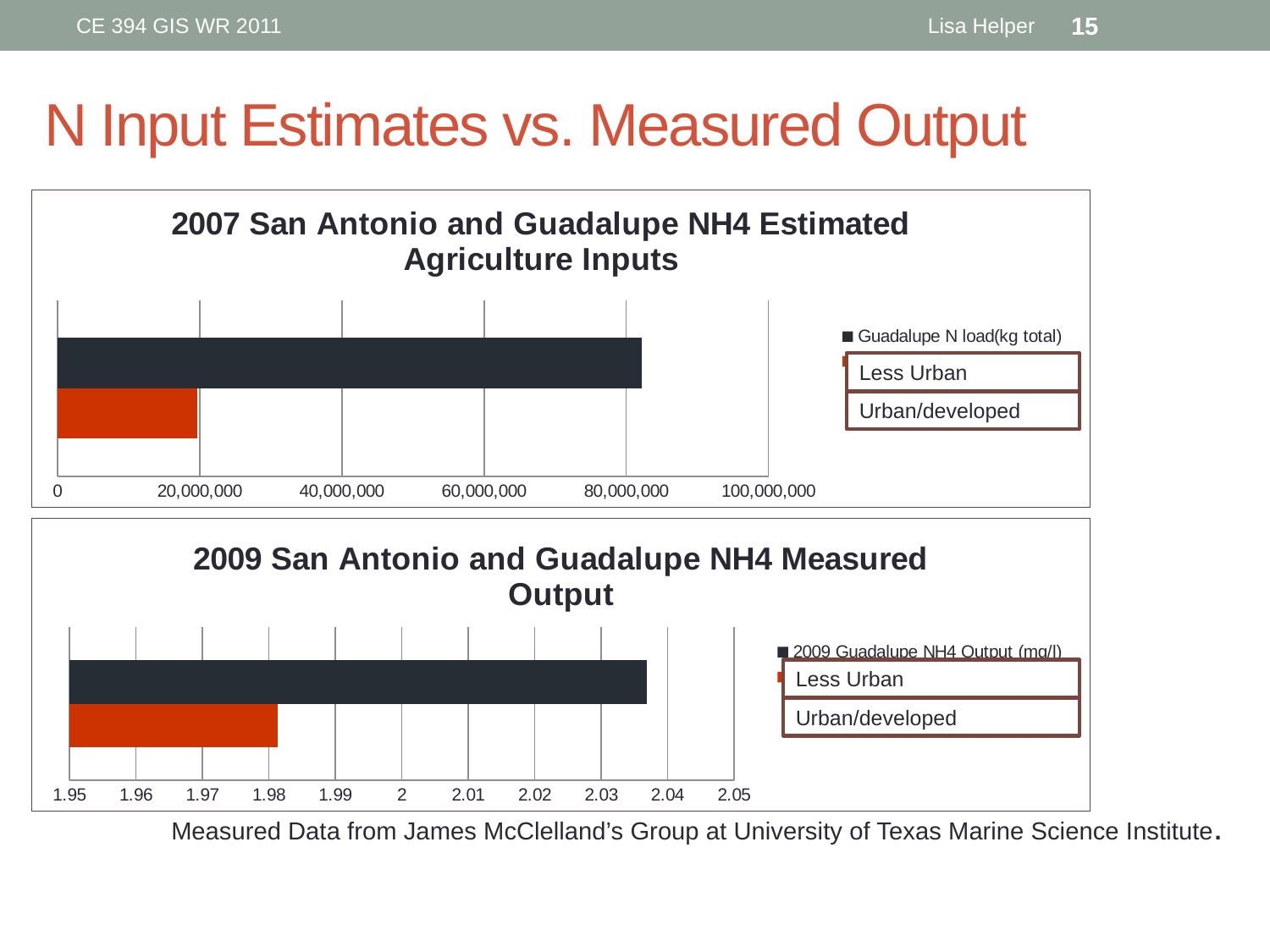
In the bottom chart (2009 Measured Output), what unit is given in the legend entry '2009 Guadalupe NH4 Output'? mg/l How many bars are plotted in the bottom chart (2009 Measured Output)? 2 What kind of chart is the bottom chart, '2009 San Antonio and Guadalupe NH4 Measured Output'? Bar chart In the bottom chart (2009 Measured Output), is the value for 2009 Guadalupe NH4 Output (mg/l) greater or less than 2.02? greater In the bottom chart (2009 Measured Output), is the value for the Urban/developed bar greater or less than 2? less How many bars are plotted in the top chart (2007 Estimated Agriculture Inputs)? 2 In the bottom chart (2009 Measured Output), which bar is larger: the 2009 Guadalupe NH4 Output (mg/l) bar or the Urban/developed bar? 2009 Guadalupe NH4 Output (mg/l) In the top chart (2007 Estimated Agriculture Inputs), is the value for Guadalupe N load(kg total) greater or less than 60,000,000? greater In the top chart (2007 Estimated Agriculture Inputs), which bar is larger: the Guadalupe N load(kg total) bar or the Urban/developed bar? Guadalupe N load(kg total) What kind of chart is the top chart, '2007 San Antonio and Guadalupe NH4 Estimated Agriculture Inputs'? Bar chart What is the title of the top chart on the slide? 2007 San Antonio and Guadalupe NH4 Estimated Agriculture Inputs